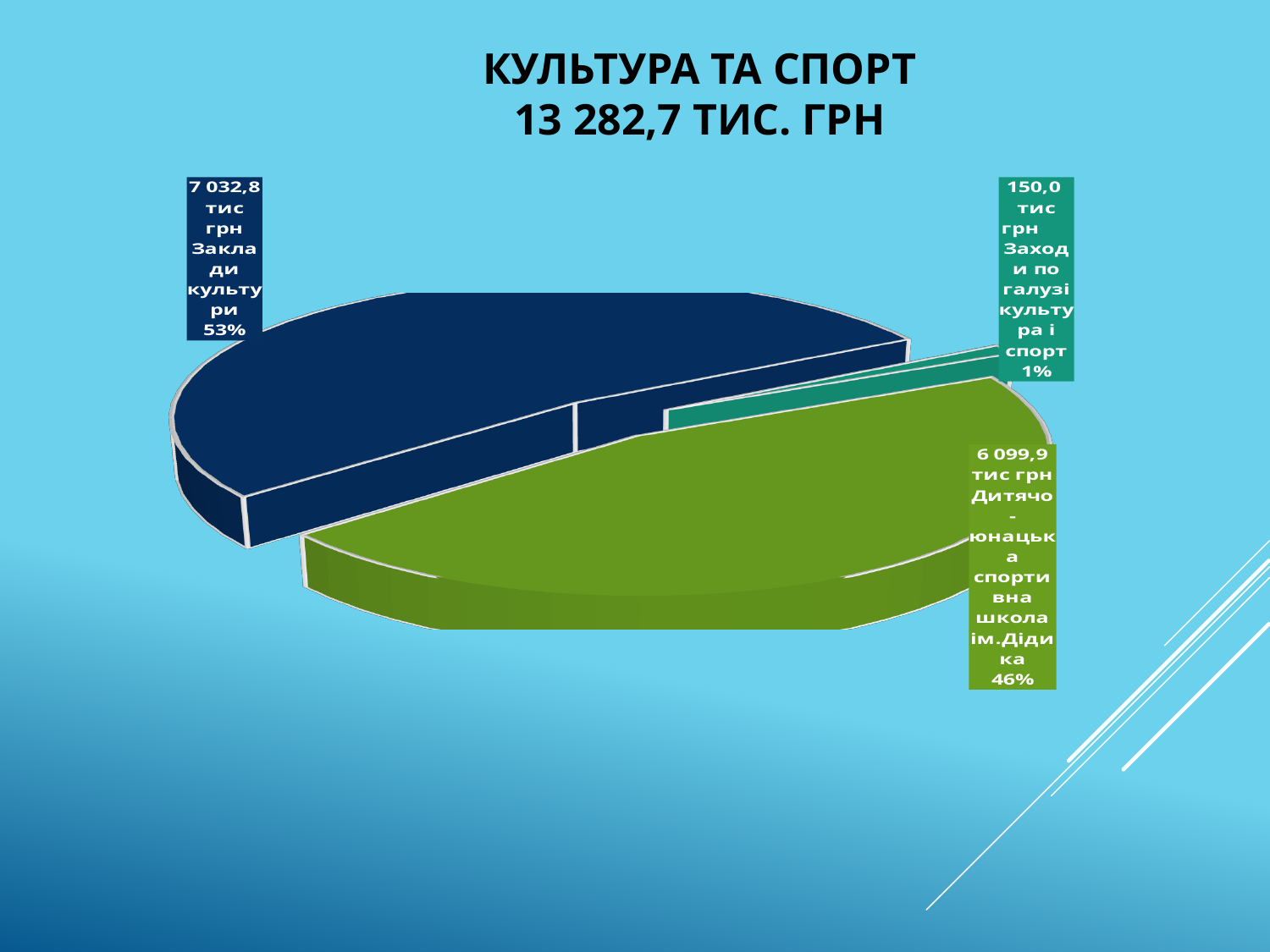
What is the value for Заходи по галузі культура і спорт? 150,0 тис грн Which category has the smallest slice? Заходи по галузі культура і спорт How many slices does the pie chart have? 3 What is the value for Заклади культури? 7 032,8 тис грн Which category has the largest slice? Заклади культури What share of the pie does Дитячо-юнацька спортивна школа ім.Дідика represent? 46% What kind of chart is shown on the slide? pie chart What is the value for Дитячо-юнацька спортивна школа ім.Дідика? 6 099,9 тис грн What is the title of the chart? КУЛЬТУРА ТА СПОРТ 13 282,7 ТИС. ГРН What is the difference between the values for Заклади культури and Дитячо-юнацька спортивна школа ім.Дідика? 932,9 тис грн What share of the pie does Заходи по галузі культура і спорт represent? 1% What share of the pie does Заклади культури represent? 53%